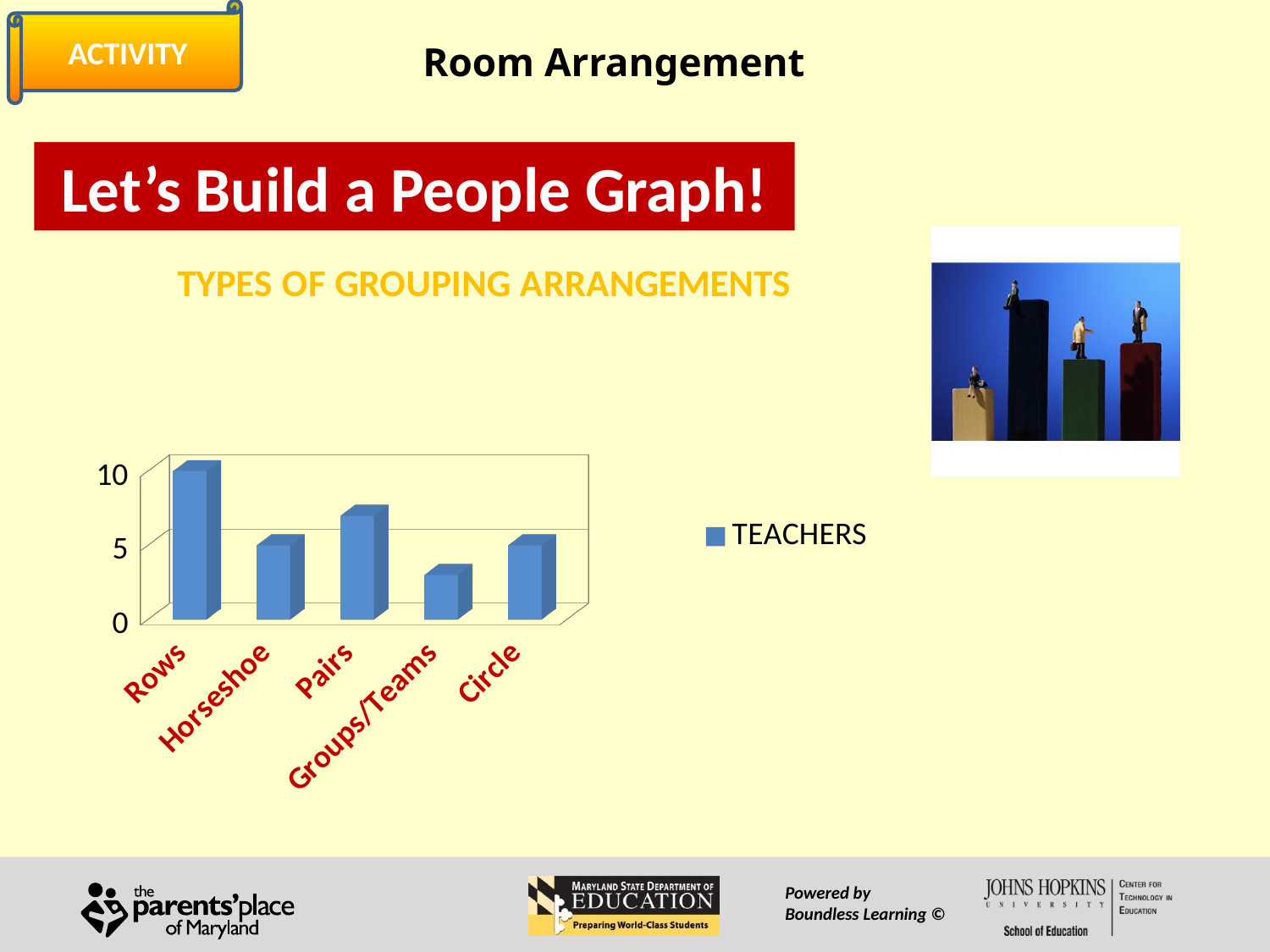
What is the title of the chart? TYPES OF GROUPING ARRANGEMENTS Is the value for Groups/Teams greater or less than 5? less How many series does the chart's legend list? 1 Which grouping arrangement has the highest bar? Rows Is the value for Rows greater or less than 5? greater Which grouping arrangement has the lowest bar? Groups/Teams Which is larger, the value for Pairs or the value for Groups/Teams? Pairs Is the value for Pairs greater or less than 5? greater How many categories are shown on the x axis of the chart? 5 What is the name of the series shown in the chart's legend? TEACHERS Which is larger, the value for Rows or the value for Pairs? Rows What type of chart is shown on the slide? bar chart